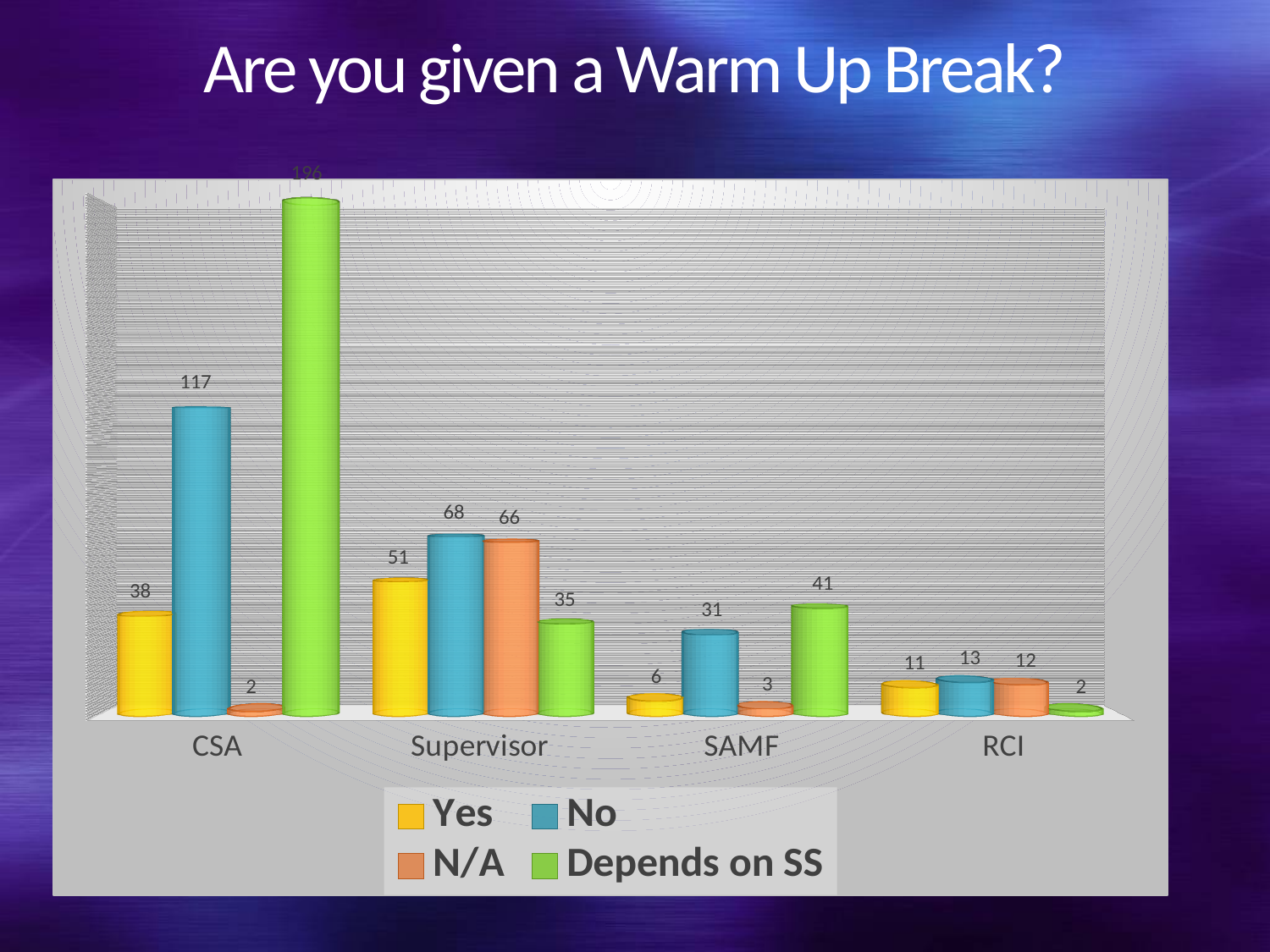
What kind of chart is shown on the slide? Bar chart What is the value for "Yes" in the RCI category? 11 What is the value for "No" in the CSA category? 117 Which series has the lowest value in the SAMF category? N/A How many series does the legend list? 4 What is the difference between the "No" and "Yes" values in the Supervisor category? 17 What is the title of the chart? Are you given a Warm Up Break? Which series has the highest value in the CSA category? Depends on SS What is the value for "Depends on SS" in the SAMF category? 41 How many categories are shown on the x axis? 4 Which is larger in the RCI category: the "No" value or the "N/A" value? No What is the value for "N/A" in the Supervisor category? 66